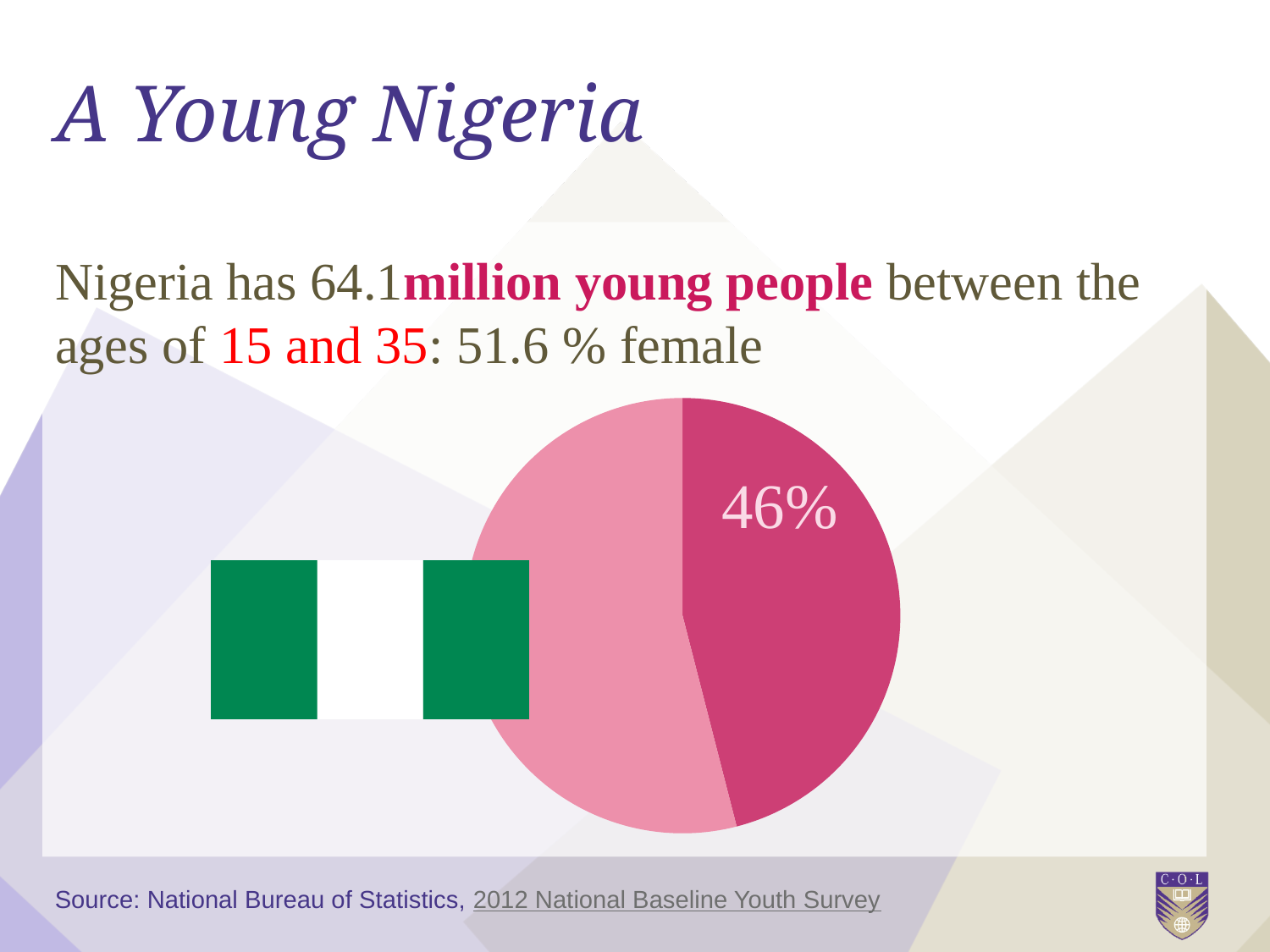
How many slices does the pie chart have? 2 What value is printed on the darker pink slice of the pie chart? 46% What is the title of the slide containing the pie chart? A Young Nigeria What kind of chart is shown on the slide? pie chart What share of the pie does the labelled slice represent? 46% Which slice of the pie chart is larger, the darker pink slice or the lighter pink slice? the lighter pink slice Is the value of the labelled slice in the pie chart greater or less than 50%? less How many slices of the pie chart have a printed data label? 1 Does the pie chart include a legend? No